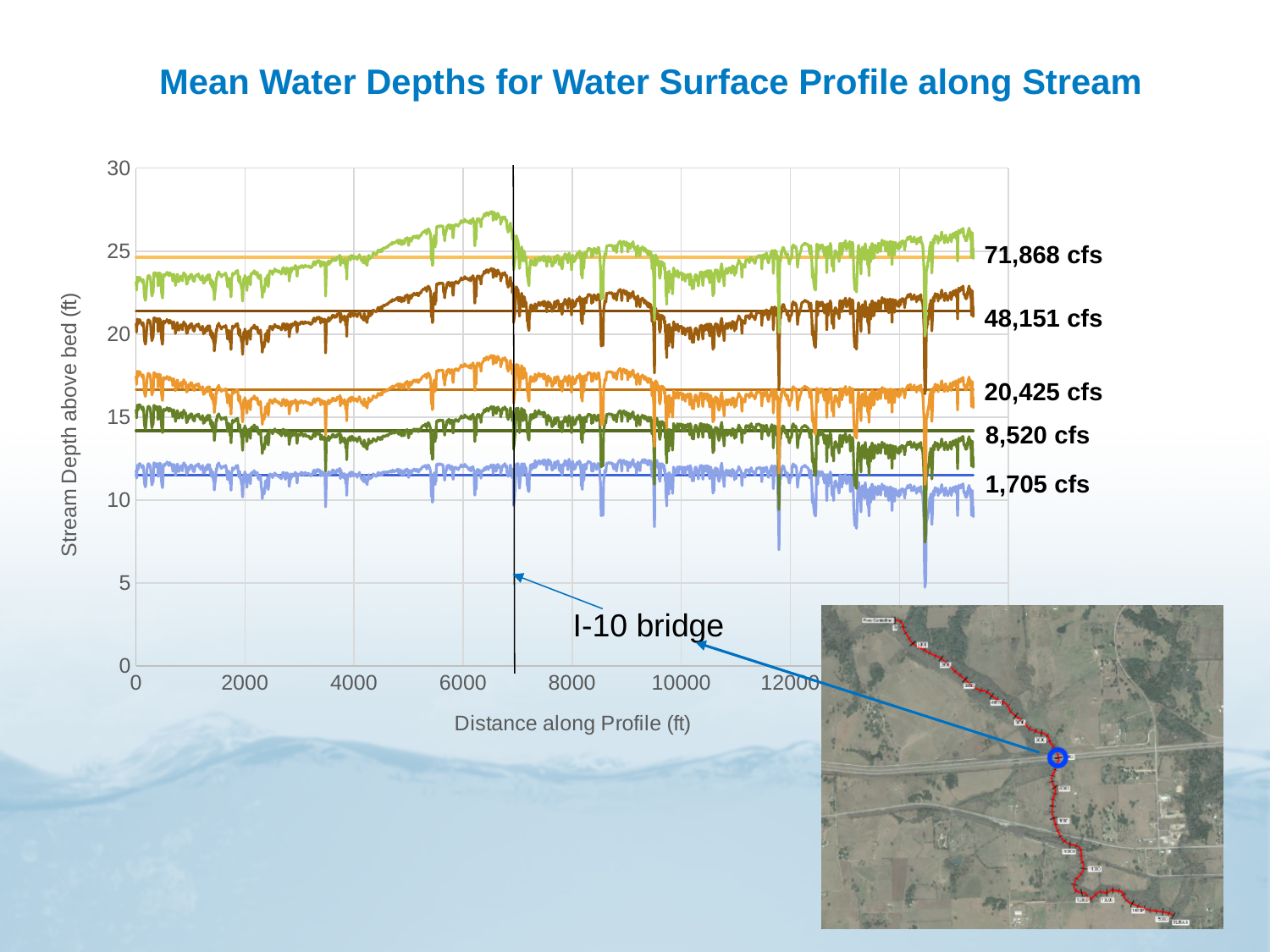
Is the mean stream depth for the 20,425 cfs series greater or less than 15 ft? greater Is the mean stream depth for the 1,705 cfs series greater or less than 15 ft? less Is the mean stream depth for the 48,151 cfs series greater or less than 25 ft? less Which series shows a greater stream depth, 48,151 cfs or 8,520 cfs? 48,151 cfs How many flow rate series (cfs labels) are shown on the chart? 5 Which flow rate series has the lowest stream depth above bed? 1,705 cfs What feature does the vertical black line on the chart mark? I-10 bridge What kind of chart is shown on the slide? line chart Which flow rate series has the highest stream depth above bed? 71,868 cfs What is the title of the chart? Mean Water Depths for Water Surface Profile along Stream